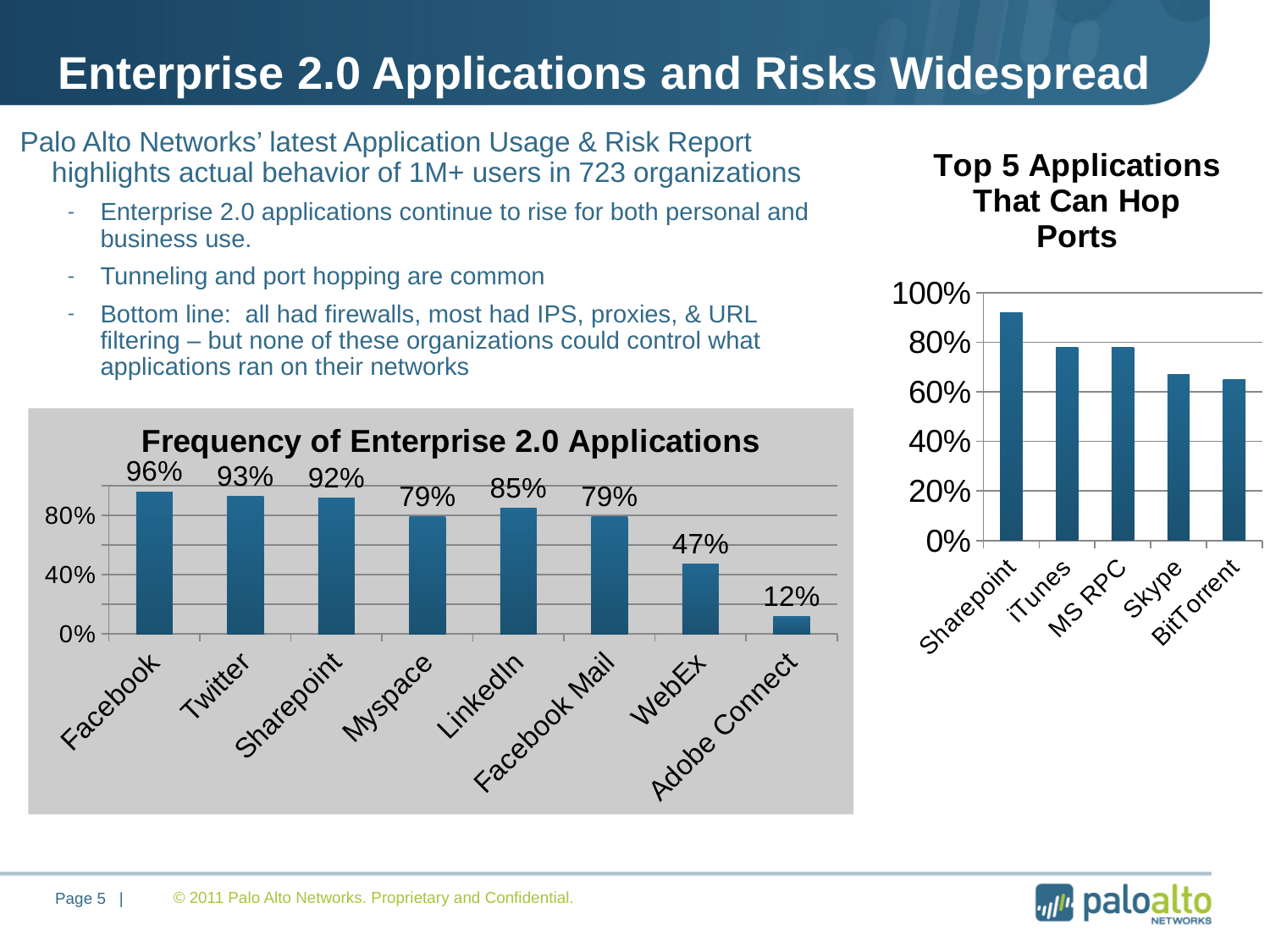
What kind of chart is the 'Top 5 Applications That Can Hop Ports' chart? Bar chart In the 'Top 5 Applications That Can Hop Ports' chart, which application has the highest value? Sharepoint In the 'Frequency of Enterprise 2.0 Applications' chart, which is larger, the value for Twitter or the value for Sharepoint? Twitter In the 'Frequency of Enterprise 2.0 Applications' chart, which application has the highest value? Facebook In the 'Frequency of Enterprise 2.0 Applications' chart, what is the difference between the values for LinkedIn and Myspace? 6% In the 'Frequency of Enterprise 2.0 Applications' chart, which application has the lowest value? Adobe Connect In the 'Top 5 Applications That Can Hop Ports' chart, is the value for Skype greater or less than 60%? greater How many applications are shown in the 'Top 5 Applications That Can Hop Ports' chart? 5 How many applications are shown in the 'Frequency of Enterprise 2.0 Applications' chart? 8 In the 'Top 5 Applications That Can Hop Ports' chart, is the value for Sharepoint greater or less than 80%? greater In the 'Frequency of Enterprise 2.0 Applications' chart, what is the value for WebEx? 47% In the 'Frequency of Enterprise 2.0 Applications' chart, what is the value for Facebook? 96%